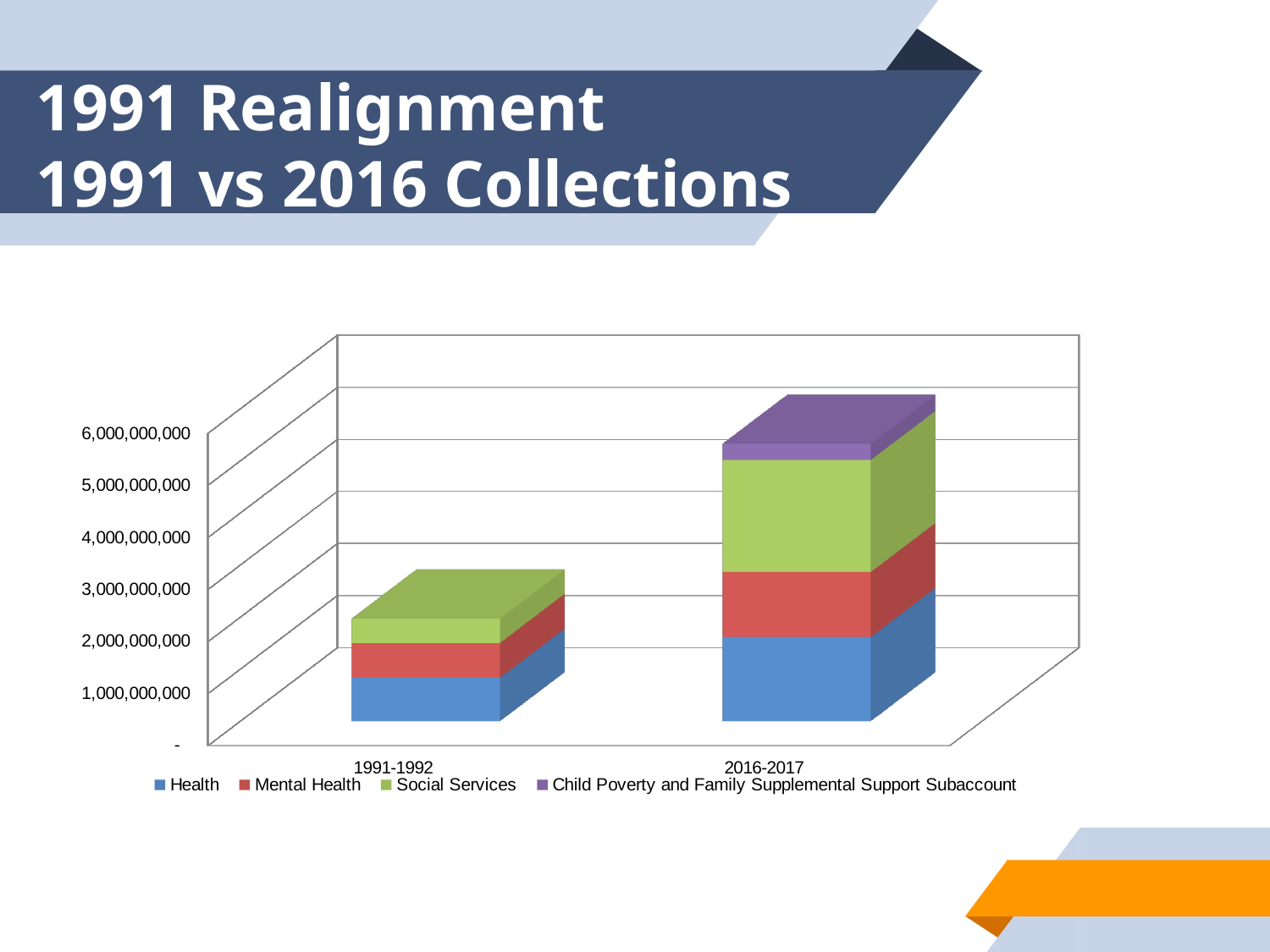
Which series appears only in the 2016-2017 bar and not in the 1991-1992 bar? Child Poverty and Family Supplemental Support Subaccount What kind of chart is shown on the slide? Stacked bar chart Which category has the higher total collections, 1991-1992 or 2016-2017? 2016-2017 Which series is the largest segment of the 2016-2017 bar? Social Services Is the total for 2016-2017 greater or less than 4,000,000,000? greater Is the Health value for 2016-2017 greater or less than 1,000,000,000? greater Which category has the lowest total collections? 1991-1992 Do total collections rise or fall from 1991-1992 to 2016-2017? Rise Is the total for 1991-1992 greater or less than 4,000,000,000? less What colour represents Mental Health in the chart? Red How many series does the legend list? 4 How many categories are shown on the x axis? 2